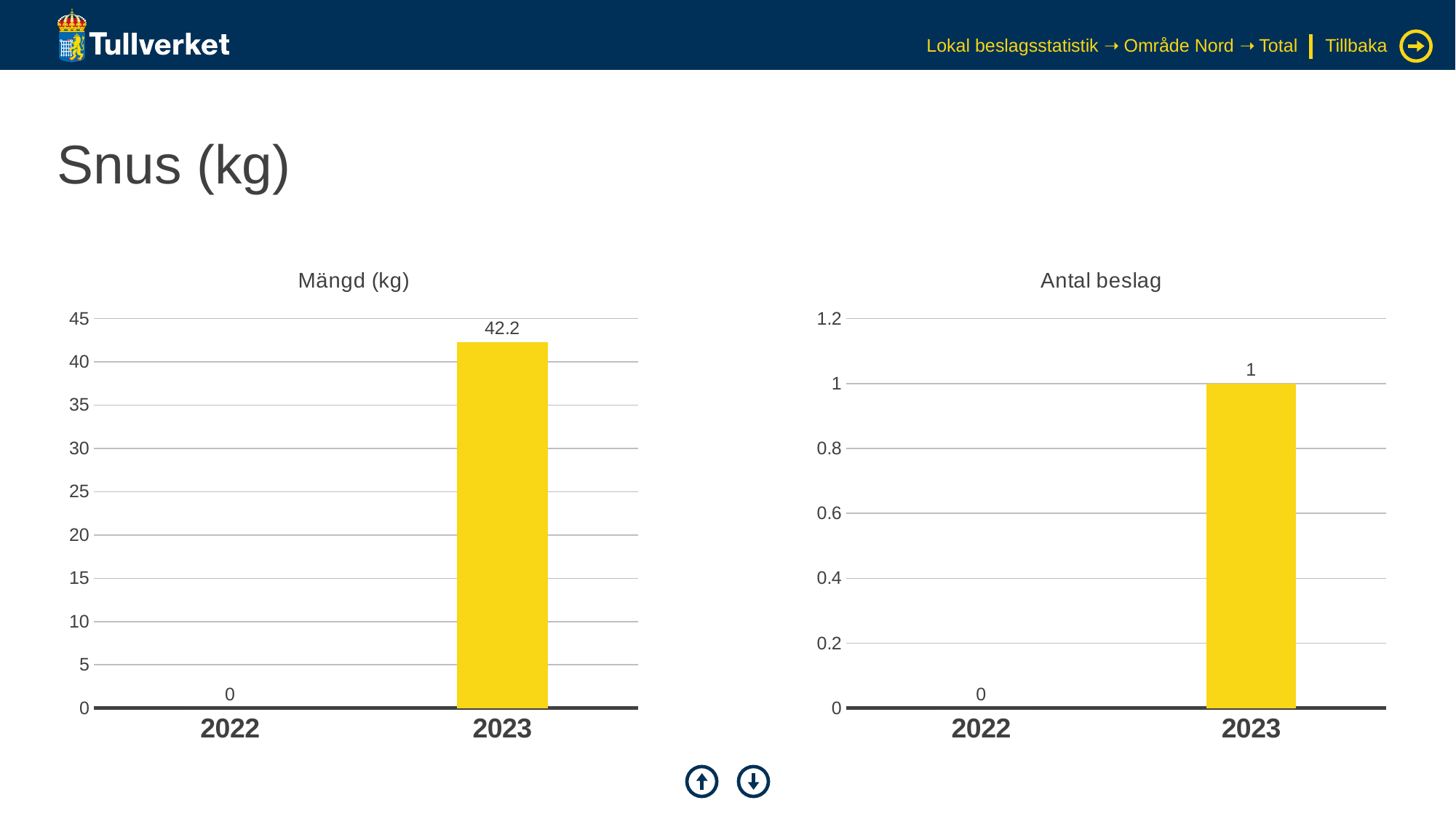
In the 'Mängd (kg)' chart, what is the difference between the 2023 and 2022 values? 42.2 In the 'Mängd (kg)' chart, what is the value for 2022? 0 In the 'Antal beslag' chart, which year has the lowest value? 2022 In the 'Antal beslag' chart, which is larger, the value for 2022 or 2023? 2023 In the 'Antal beslag' chart, what is the value for 2022? 0 In the 'Mängd (kg)' chart, do the values rise or fall from 2022 to 2023? rise In the 'Mängd (kg)' chart, what is the value for 2023? 42.2 In the 'Mängd (kg)' chart, which year has the highest value? 2023 In the 'Mängd (kg)' chart, is the value for 2023 greater or less than 40? greater What kind of chart is the 'Antal beslag' chart? bar chart In the 'Antal beslag' chart, what is the value for 2023? 1 How many categories are shown on the x axis of the 'Mängd (kg)' chart? 2